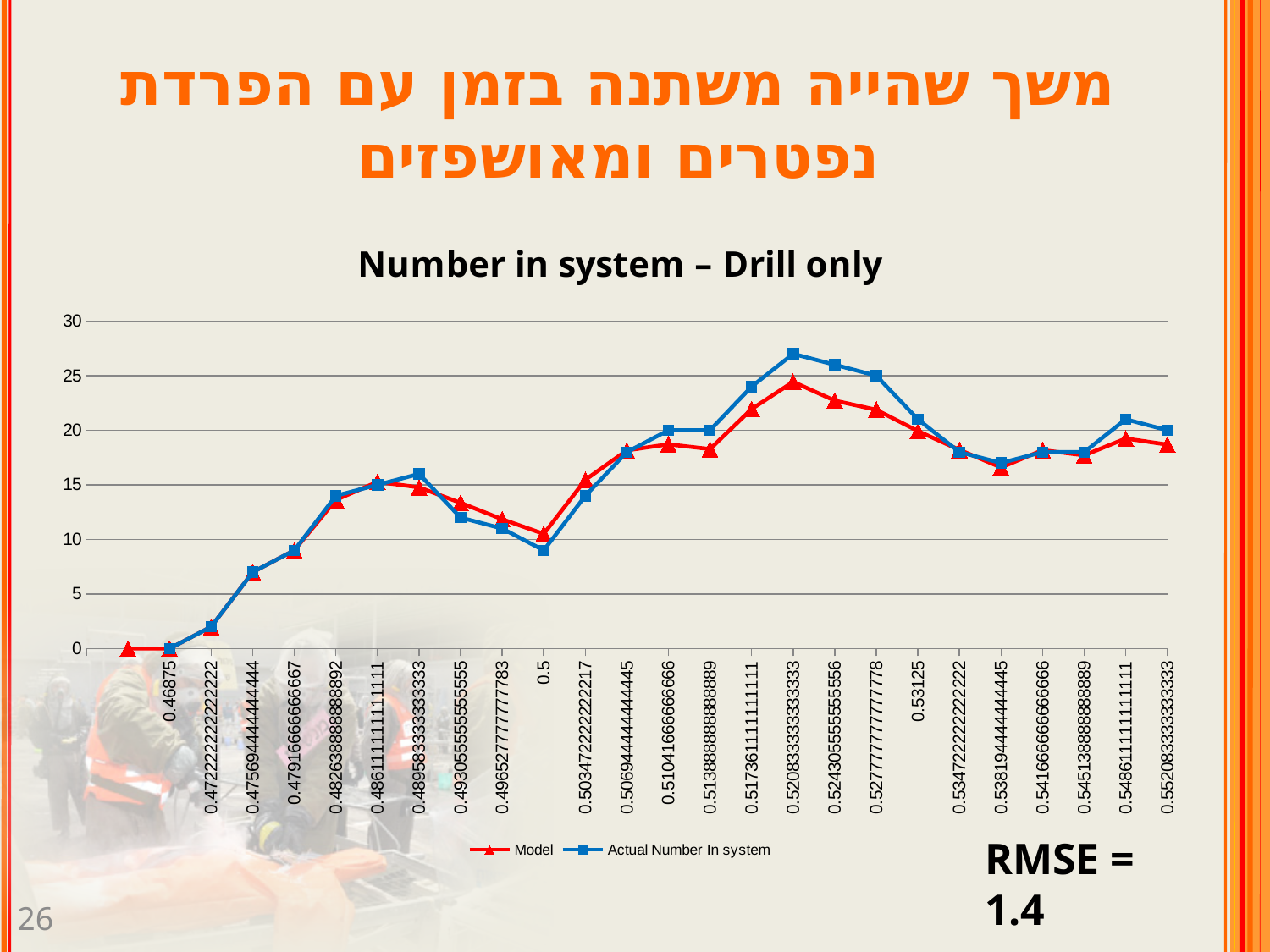
Which series is drawn with blue square markers? Actual Number In system Do the values of Actual Number In system rise or fall between 0.4722222222222222 and 0.4861111111111111? rise At 0.5243055555555556, which series has the larger value, Model or Actual Number In system? Actual Number In system Is the value of Model at 0.5208333333333333 greater or less than 25? less At which x-axis value does the Actual Number In system series reach its highest point? 0.5208333333333333 Is the value of Actual Number In system at 0.4722222222222222 greater or less than 5? less What is the title of the chart? Number in system – Drill only How many series does the legend list? 2 What kind of chart is shown on the slide? line chart Is the value of Actual Number In system at 0.5 greater or less than 10? less At 0.5, which series has the larger value, Model or Actual Number In system? Model